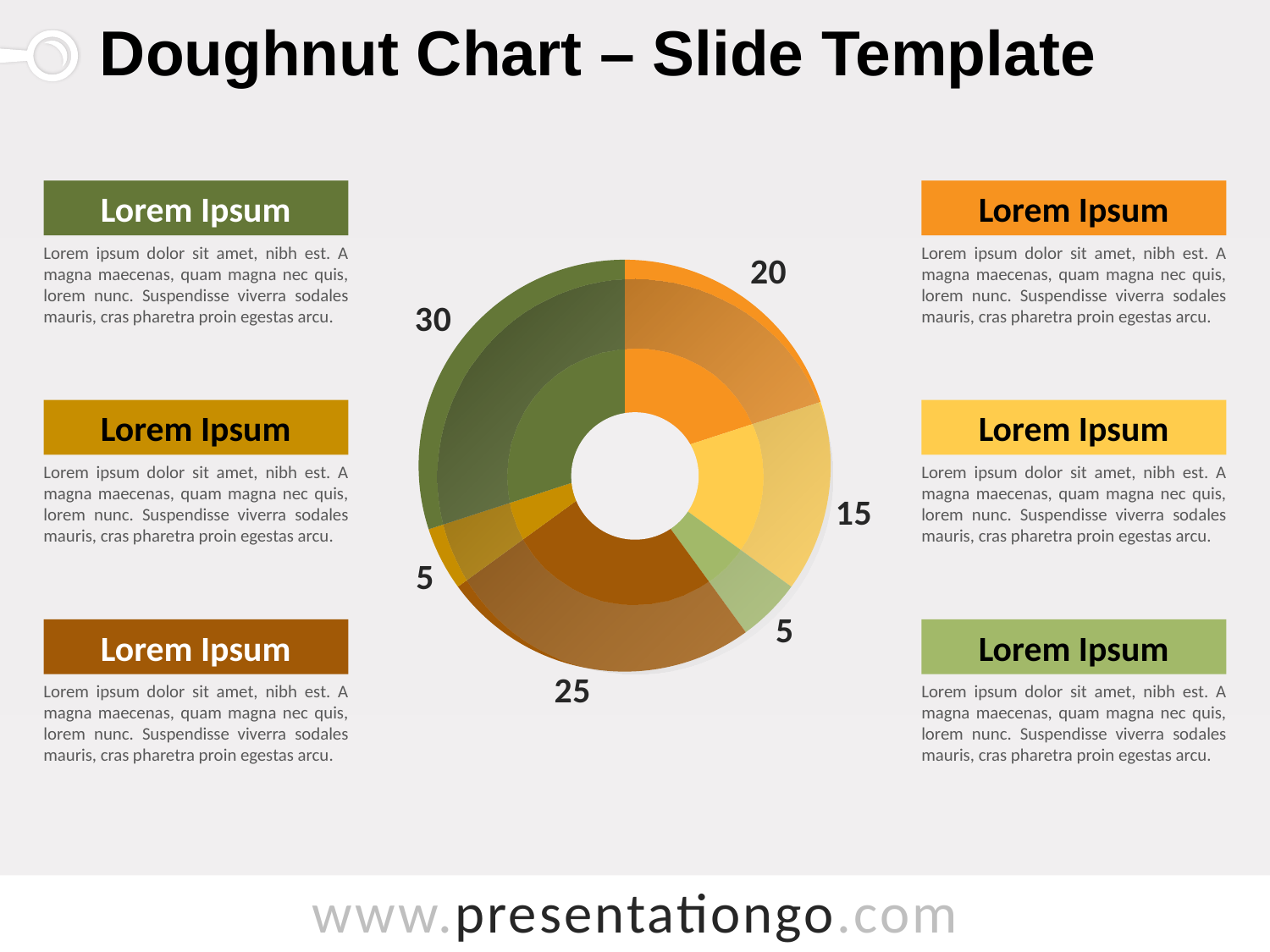
What is the value of the dark green slice at the top left of the doughnut chart? 30 What is the largest value shown on the doughnut chart? 30 What kind of chart is shown on the slide? Doughnut chart What is the value of the orange slice at the top right of the doughnut chart? 20 What share of the doughnut chart does the dark green slice (30) represent? 30% What is the total of all the values shown on the doughnut chart? 100 What is the difference between the dark green slice (30) and the orange slice (20)? 10 What is the value of the yellow slice on the right side of the doughnut chart? 15 What is the smallest value shown on the doughnut chart? 5 What is the value of the brown slice at the bottom of the doughnut chart? 25 Which is larger, the brown slice or the yellow slice? The brown slice (25) How many slices does the doughnut chart have? 6